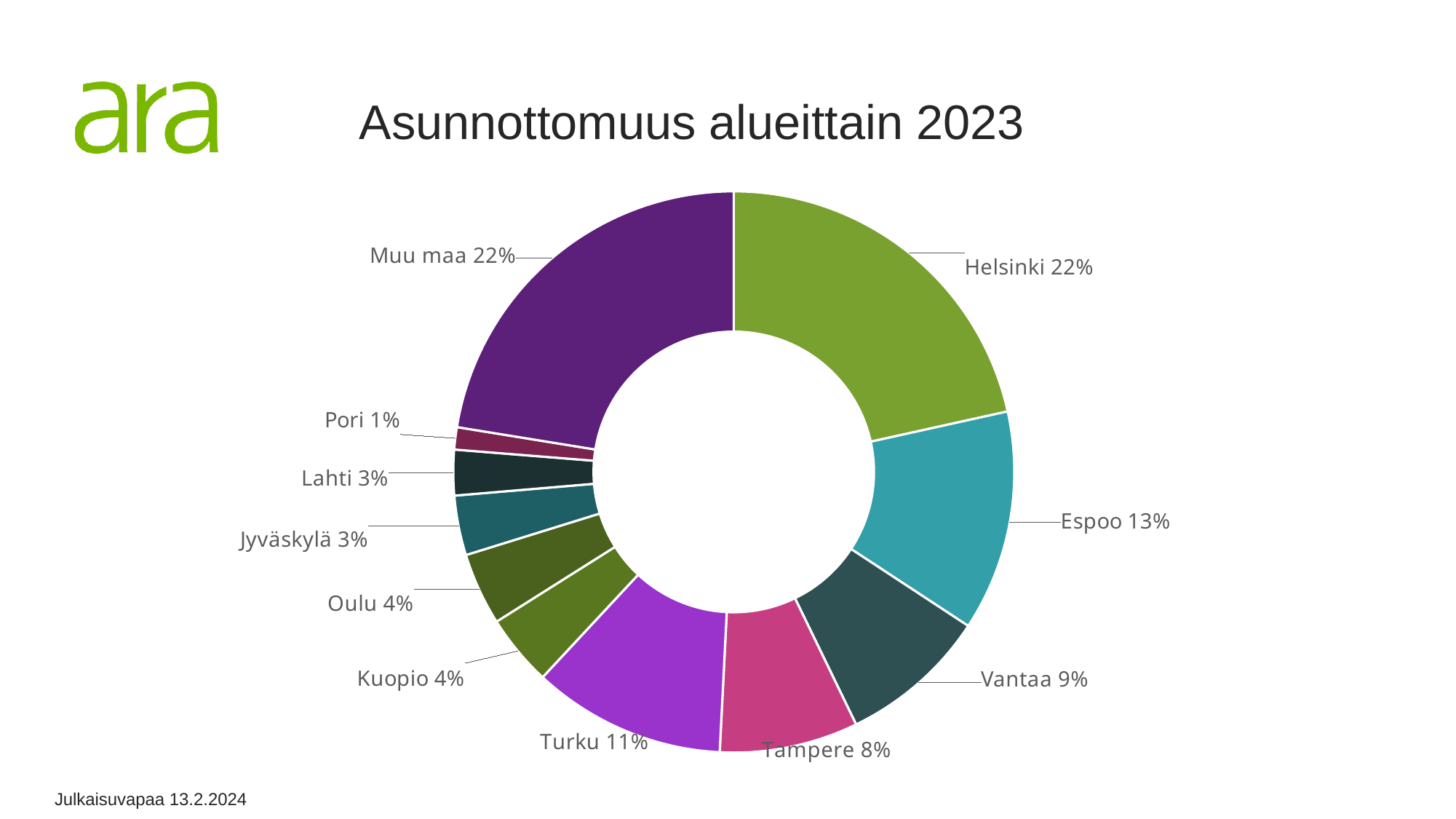
Which is larger, the share for Turku or the share for Tampere? Turku What is the value shown for Tampere? 8% What share of the pie does Espoo have? 13% What share of the pie does Turku have? 11% What is the difference between the shares of Espoo and Vantaa? 4% What is the value shown for Vantaa? 9% What is the difference between the shares of Helsinki and Turku? 11% Which is larger, the share for Oulu or the share for Lahti? Oulu What is the title of the chart? Asunnottomuus alueittain 2023 How many categories are shown in the chart? 11 Which category has the smallest share? Pori What kind of chart is shown on the slide? Pie chart (doughnut)